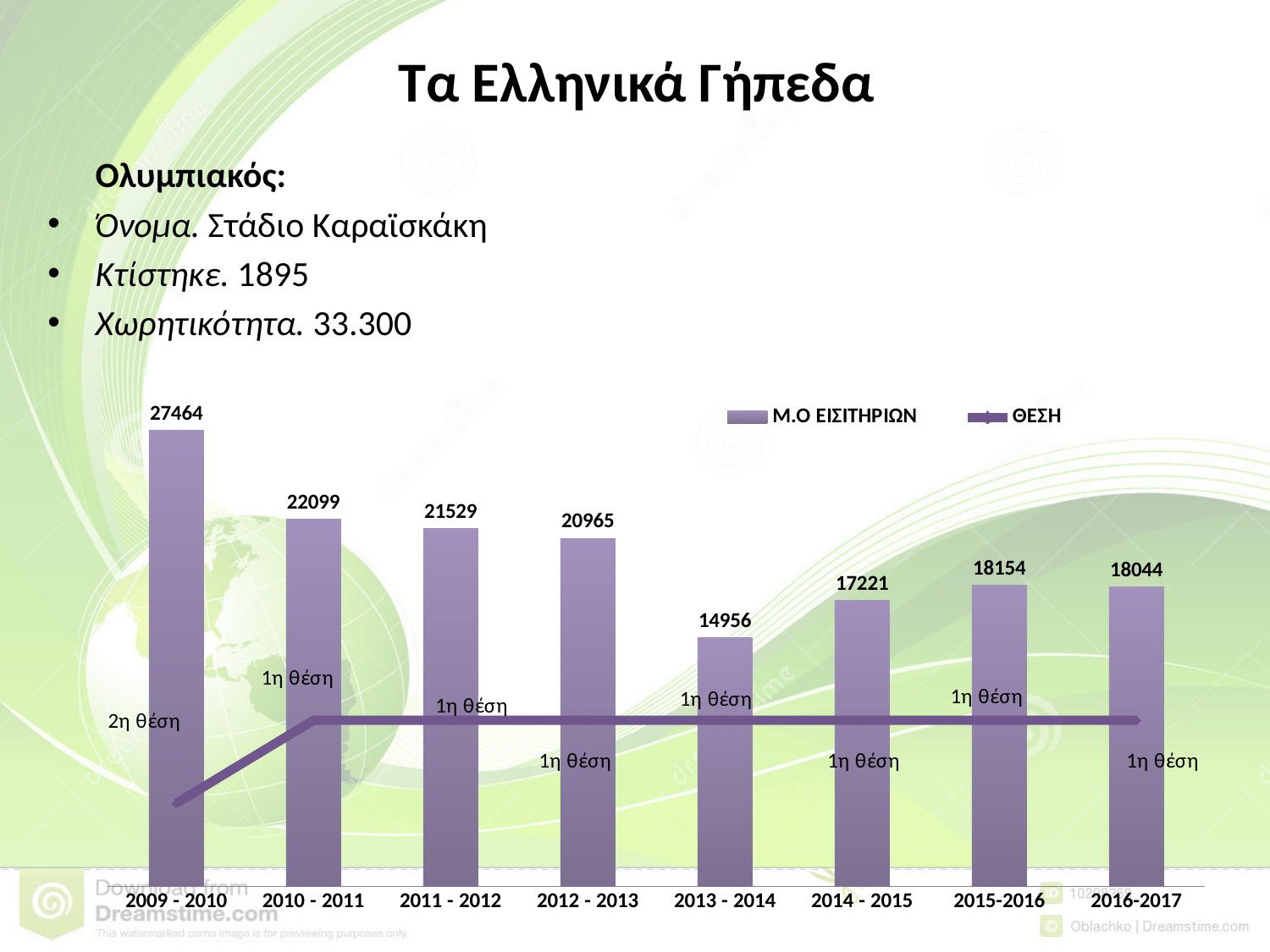
What ΘΕΣΗ is shown for the 2009 - 2010 season? 2η θέση Which season has a larger Μ.Ο ΕΙΣΙΤΗΡΙΩΝ value, 2014 - 2015 or 2015-2016? 2015-2016 What is the difference between the Μ.Ο ΕΙΣΙΤΗΡΙΩΝ values for 2009 - 2010 and 2010 - 2011? 5365 Does the Μ.Ο ΕΙΣΙΤΗΡΙΩΝ value rise or fall from 2009 - 2010 to 2013 - 2014? Fall What is the Μ.Ο ΕΙΣΙΤΗΡΙΩΝ value for the 2013 - 2014 season? 14956 What is the Μ.Ο ΕΙΣΙΤΗΡΙΩΝ value for the 2016-2017 season? 18044 What is the Μ.Ο ΕΙΣΙΤΗΡΙΩΝ value for the 2009 - 2010 season? 27464 What kind of chart is used to show the Μ.Ο ΕΙΣΙΤΗΡΙΩΝ series? Bar chart How many series does the chart legend list? 2 Which season has the lowest Μ.Ο ΕΙΣΙΤΗΡΙΩΝ value? 2013 - 2014 How many seasons are shown on the x axis of the chart? 8 Which season has the highest Μ.Ο ΕΙΣΙΤΗΡΙΩΝ value? 2009 - 2010